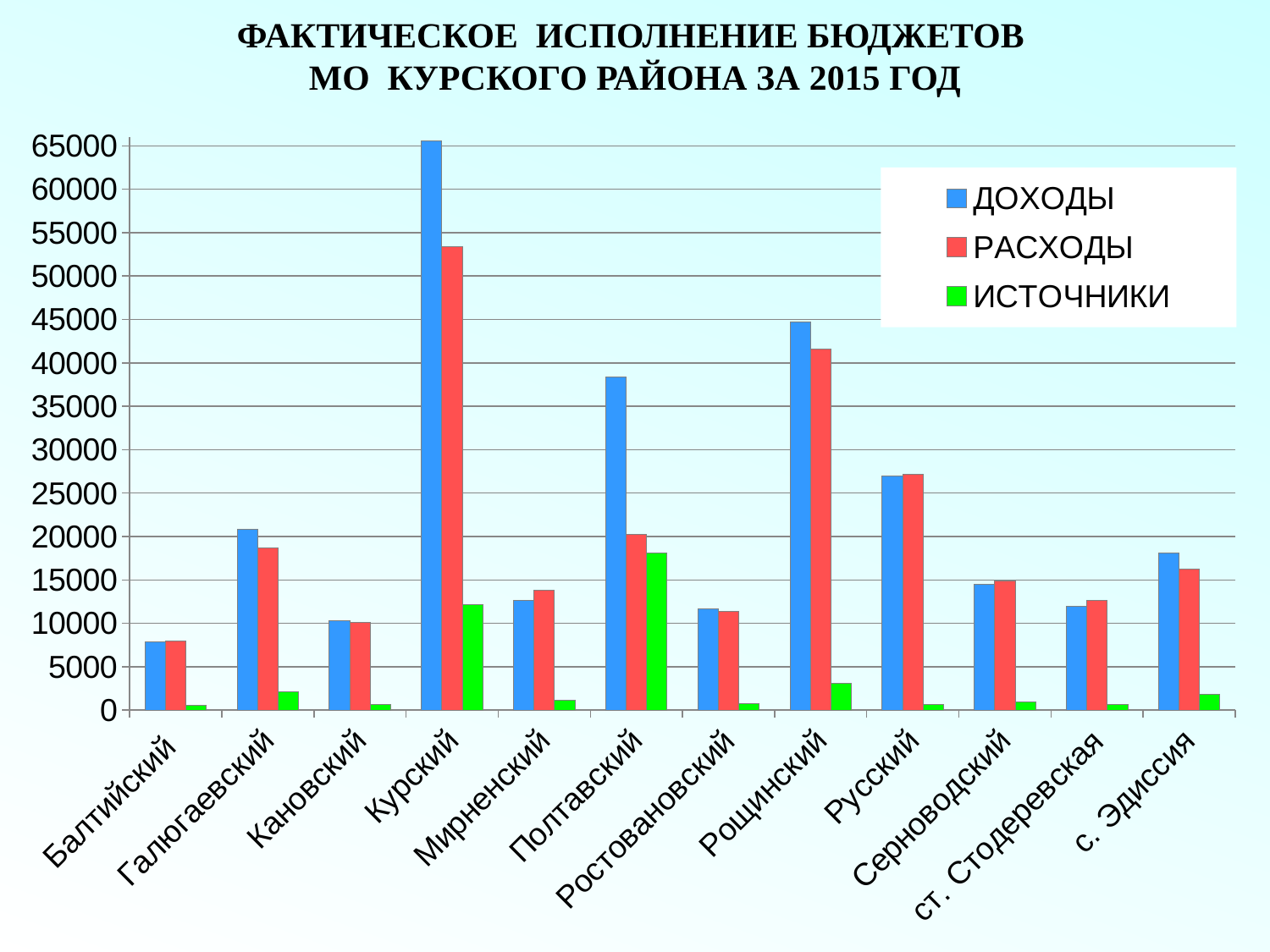
Which municipality has the highest ДОХОДЫ value? Курский Which municipality has the lowest ДОХОДЫ value? Балтийский Which series is shown in green in the legend? ИСТОЧНИКИ For Курский, which is larger: ДОХОДЫ or РАСХОДЫ? ДОХОДЫ Which municipality has the highest РАСХОДЫ value? Курский How many series does the legend list? 3 Which municipality has the highest ИСТОЧНИКИ value? Полтавский Is the ДОХОДЫ value for Курский greater or less than 60000? greater What kind of chart is shown on the slide? bar chart Is the ДОХОДЫ value for Рощинский greater or less than 40000? greater Is the ИСТОЧНИКИ value for Полтавский greater or less than 15000? greater How many municipalities (categories) are shown on the x axis? 12